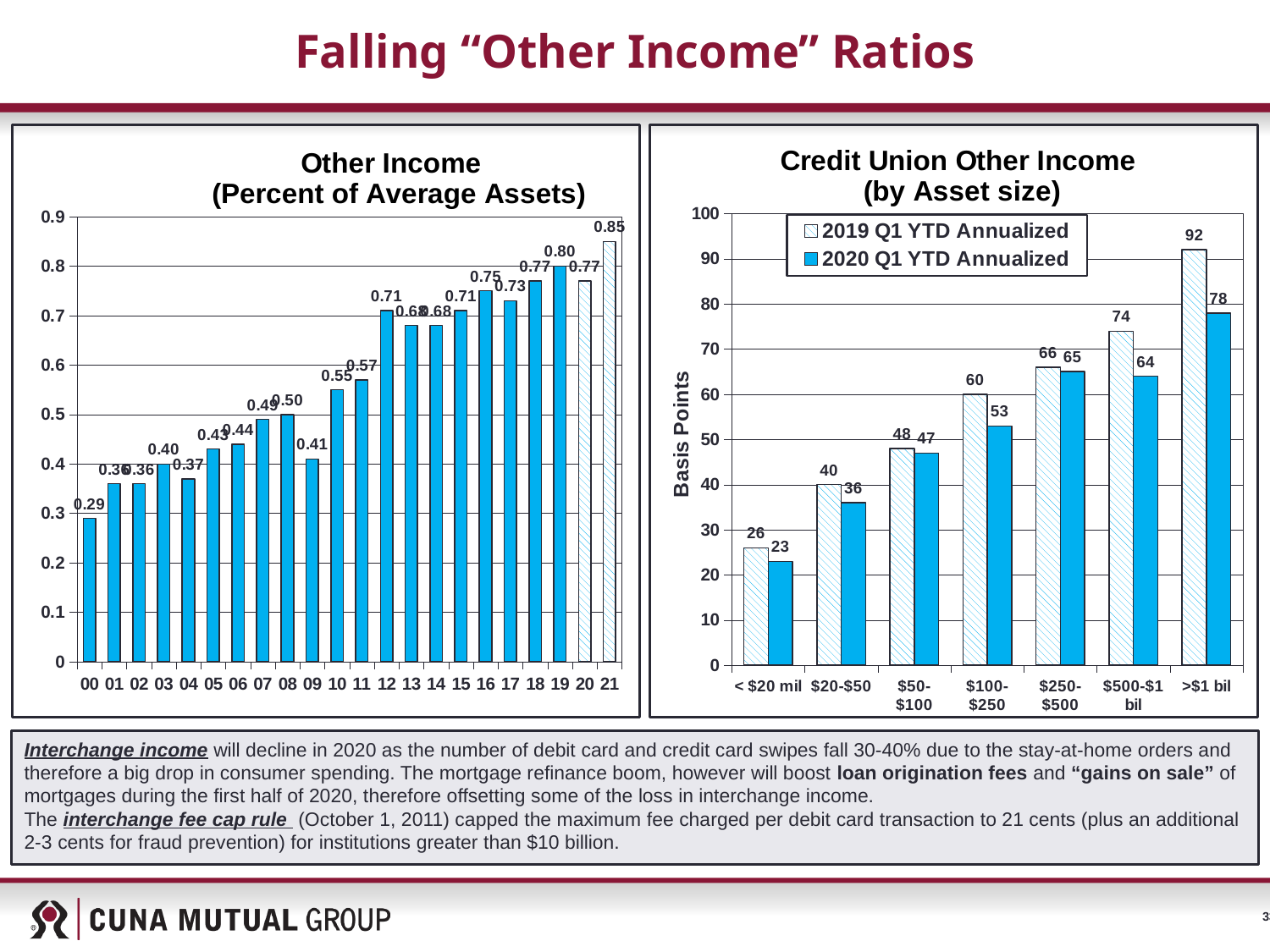
In the "Other Income (Percent of Average Assets)" chart, what is the value for 09? 0.41 In the "Credit Union Other Income (by Asset size)" chart, what is the 2019 Q1 YTD Annualized value for $100-$250? 60 In the "Other Income (Percent of Average Assets)" chart, do the values generally rise or fall from 00 to 21? rise In the "Other Income (Percent of Average Assets)" chart, how many years are shown on the x axis? 22 In the "Other Income (Percent of Average Assets)" chart, which year has the lowest value? 00 In the "Other Income (Percent of Average Assets)" chart, what is the value for 21? 0.85 In the "Other Income (Percent of Average Assets)" chart, what is the difference between the values for 19 and 20? 0.03 In the "Credit Union Other Income (by Asset size)" chart, what is the 2020 Q1 YTD Annualized value for >$1 bil? 78 In the "Credit Union Other Income (by Asset size)" chart, how many series does the legend list? 2 In the "Credit Union Other Income (by Asset size)" chart, what is the difference between the 2019 and 2020 Q1 YTD Annualized values for $500-$1 bil? 10 In the "Credit Union Other Income (by Asset size)" chart, which asset size has the highest 2019 Q1 YTD Annualized value? >$1 bil In the "Credit Union Other Income (by Asset size)" chart, what is the label of the y axis? Basis Points